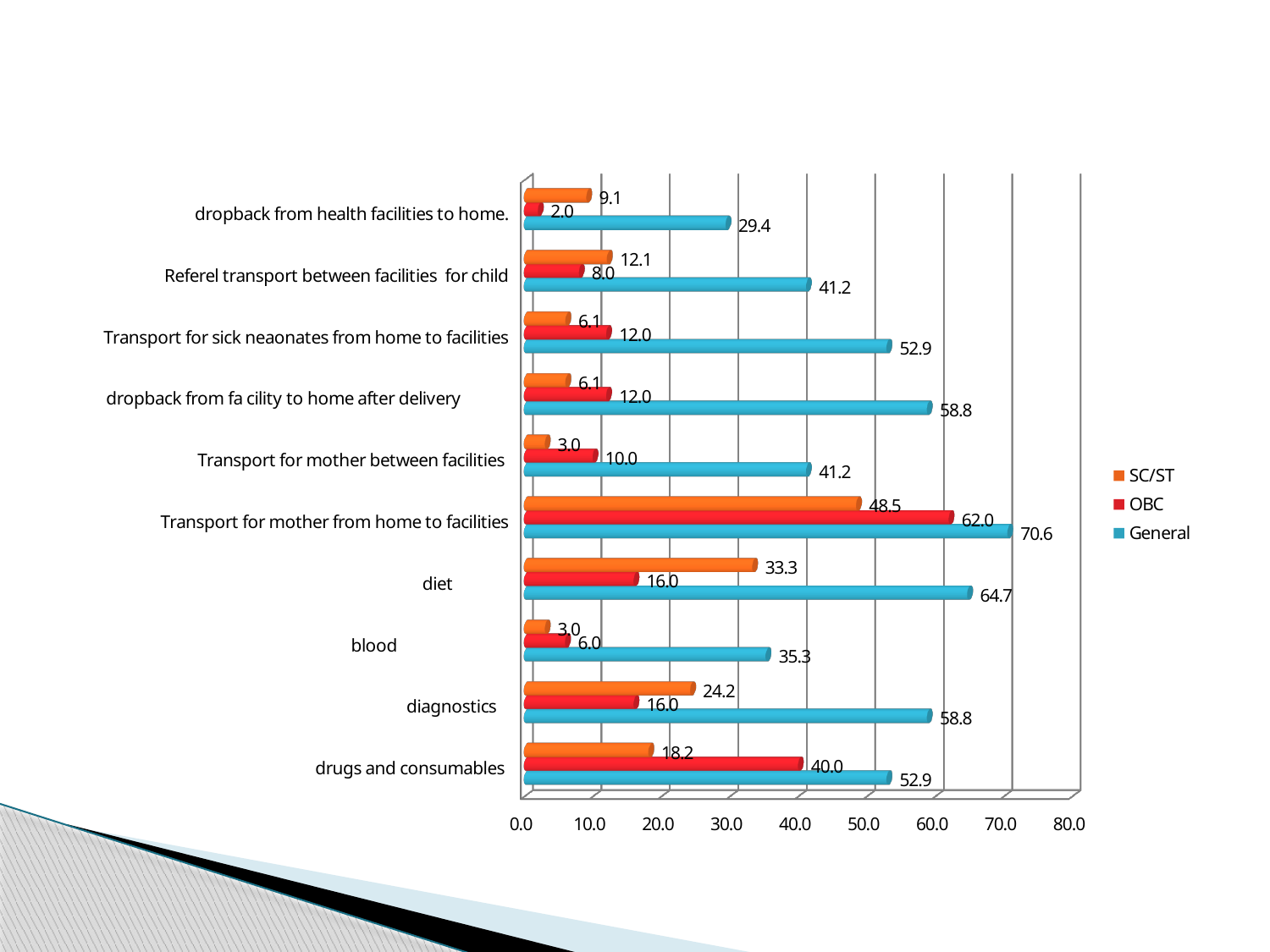
Which is larger for blood: the SC/ST value or the OBC value? OBC What is the General value for diet? 64.7 What is the SC/ST value for diagnostics? 24.2 Which category has the lowest OBC value? dropback from health facilities to home. How many categories are plotted on the chart? 10 Is the General value for dropback from health facilities to home. greater or less than 30.0? less Which category has the highest General value? Transport for mother from home to facilities Which series is shown in blue in the legend? General What kind of chart is shown on the slide? bar chart What is the OBC value for drugs and consumables? 40.0 How many series does the legend list? 3 What is the difference between the General and OBC values for Transport for mother from home to facilities? 8.6